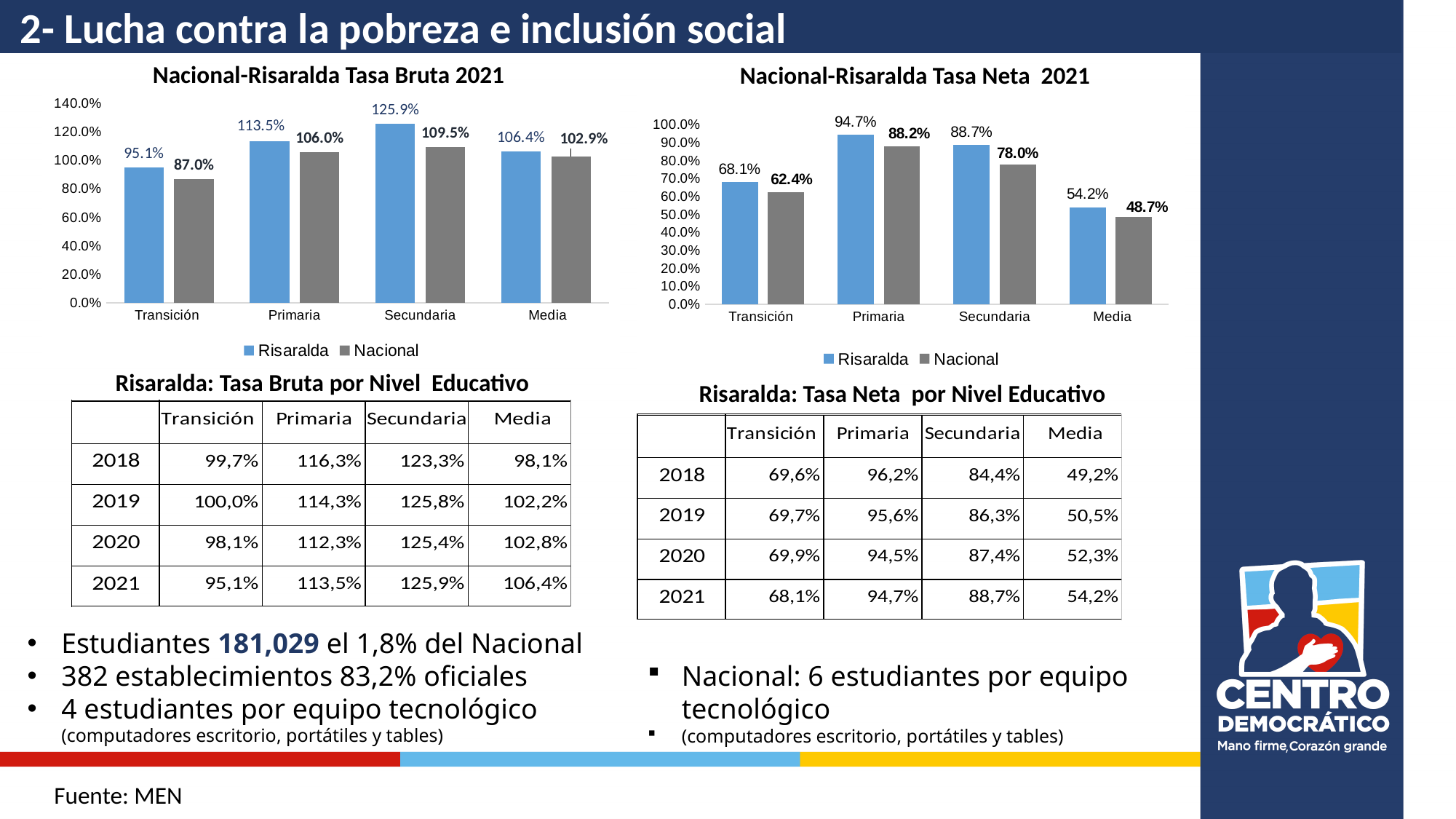
In the 'Nacional-Risaralda Tasa Bruta 2021' chart, what is the difference between the Risaralda and Nacional values for Primaria? 7.5% In the 'Nacional-Risaralda Tasa Bruta 2021' chart, what is the Nacional value for Transición? 87.0% In the 'Nacional-Risaralda Tasa Neta 2021' chart, what is the Nacional value for Secundaria? 78.0% In the 'Nacional-Risaralda Tasa Bruta 2021' chart, what is the Risaralda value for Secundaria? 125.9% What type of chart is the 'Nacional-Risaralda Tasa Bruta 2021' chart? Bar chart How many series does the legend of the 'Nacional-Risaralda Tasa Neta 2021' chart list? 2 In the 'Nacional-Risaralda Tasa Neta 2021' chart, what is the difference between the Risaralda and Nacional values for Secundaria? 10.7% In the 'Nacional-Risaralda Tasa Neta 2021' chart, which category has the lowest Nacional value? Media In the 'Nacional-Risaralda Tasa Neta 2021' chart, what is the Risaralda value for Media? 54.2% In the 'Nacional-Risaralda Tasa Bruta 2021' chart, which category has the highest Risaralda value? Secundaria In the 'Nacional-Risaralda Tasa Neta 2021' chart, which is larger for Transición: the Risaralda value or the Nacional value? Risaralda In the 'Nacional-Risaralda Tasa Bruta 2021' chart, how many categories are shown on the x axis? 4